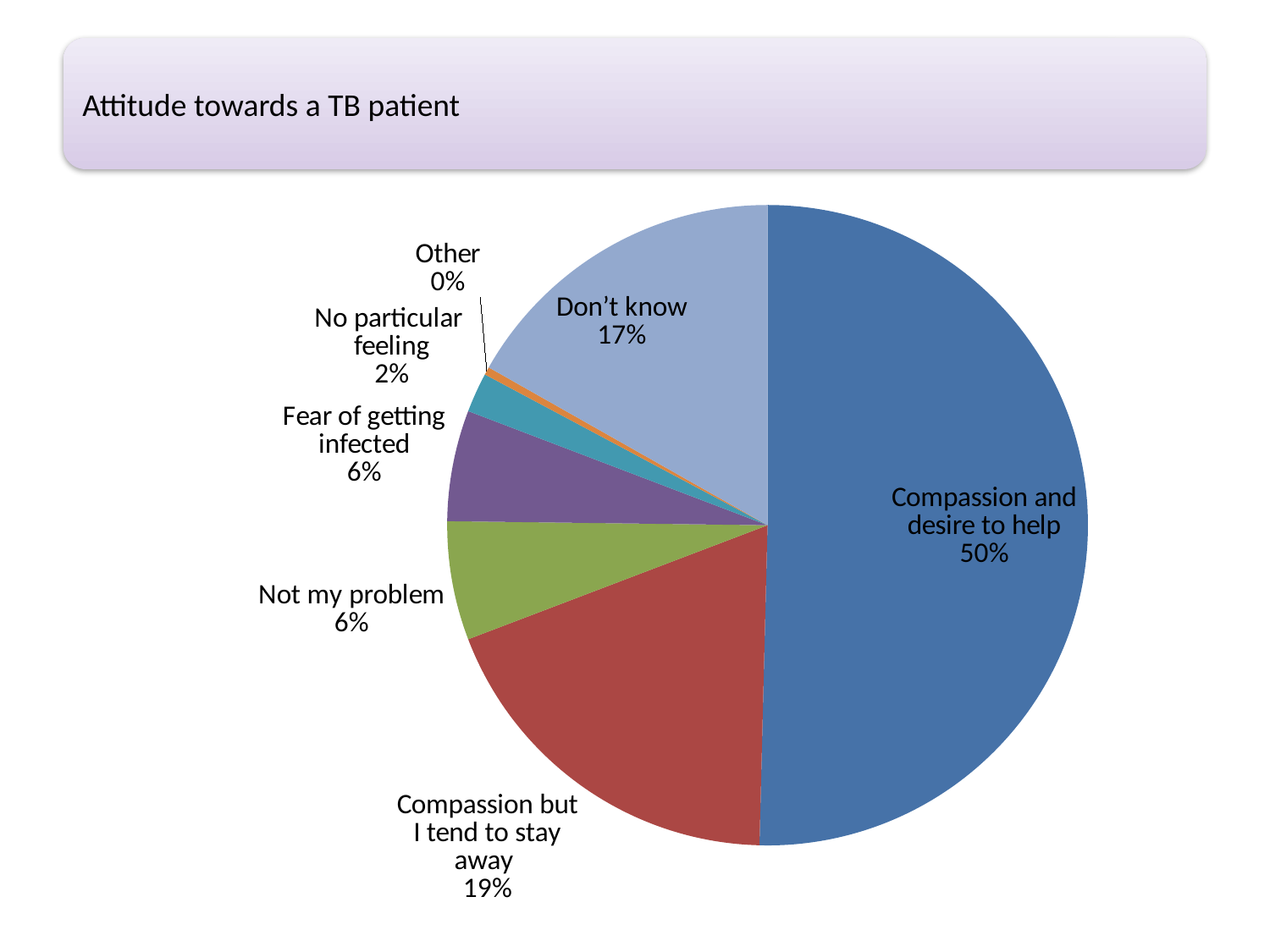
Which category has the largest slice of the pie? Compassion and desire to help How many categories are shown in the pie chart? 7 What is the title shown at the top of the slide? Attitude towards a TB patient What is the difference in percentage points between 'Compassion and desire to help' and 'Compassion but I tend to stay away'? 31 What percentage is shown for 'Don't know'? 17% What share of the pie is labelled 'Compassion and desire to help'? 50% What kind of chart is shown on the slide? Pie chart What percentage is shown for 'Compassion but I tend to stay away'? 19% Which category has the smallest slice of the pie? Other Which is larger, 'Don't know' or 'Fear of getting infected'? Don't know What percentage is shown for 'No particular feeling'? 2% What percentage is shown for 'Fear of getting infected'? 6%